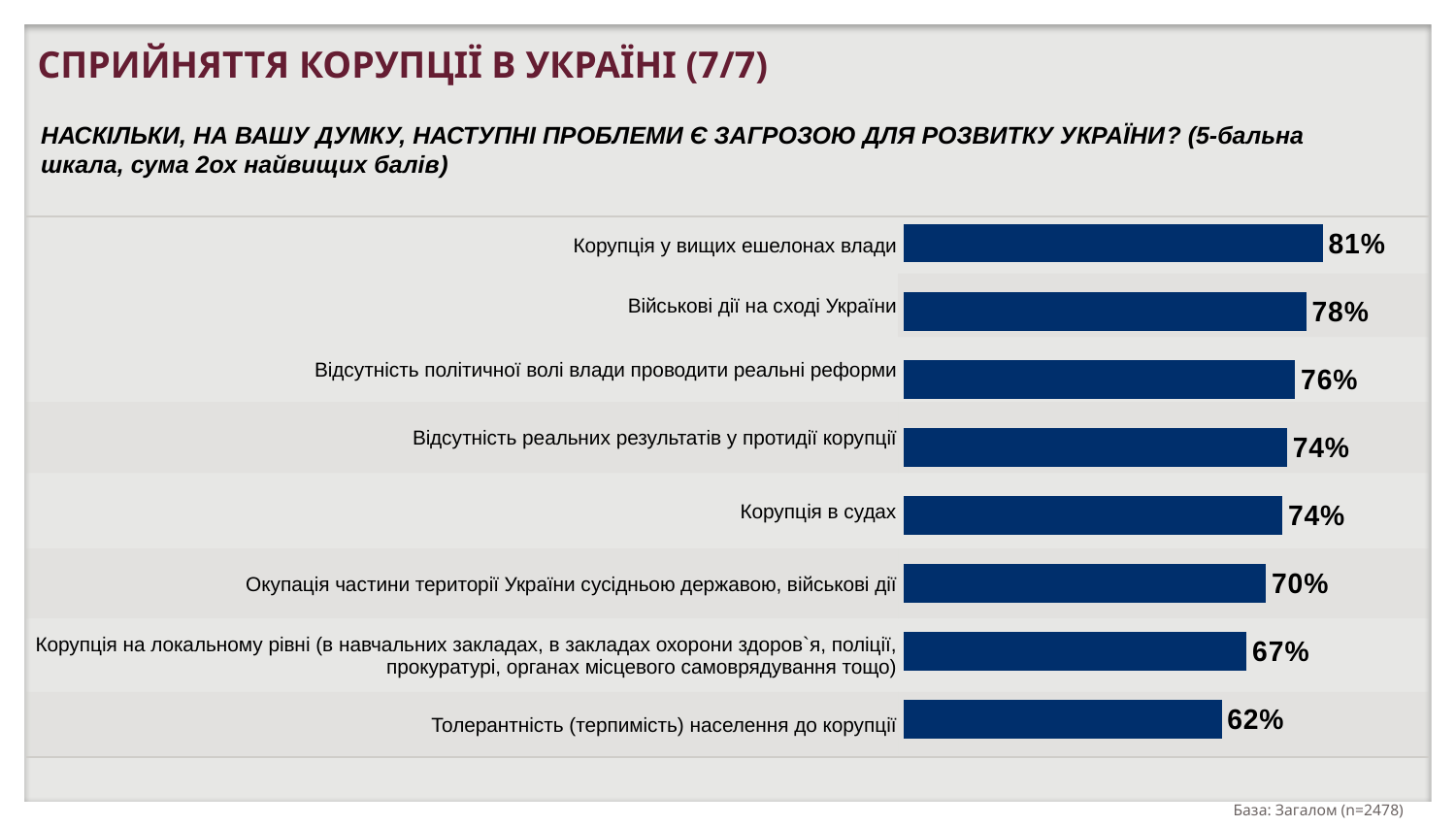
What value is shown for "Корупція у вищих ешелонах влади"? 81% Which category has the lowest value? Толерантність (терпимість) населення до корупції How many categories are shown in the chart? 8 What value is shown for "Окупація частини території України сусідньою державою, військові дії"? 70% Which category has the highest value? Корупція у вищих ешелонах влади Which is larger: the value for "Військові дії на сході України" or the value for "Корупція в судах"? Військові дії на сході України What is the sample size (base) stated at the bottom of the slide? n=2478 What value is shown for "Толерантність (терпимість) населення до корупції"? 62% What value is shown for "Військові дії на сході України"? 78% What kind of chart is shown on the slide? Bar chart What is the difference between the values for "Корупція у вищих ешелонах влади" and "Толерантність (терпимість) населення до корупції"? 19% What is the difference between the values for "Відсутність політичної волі влади проводити реальні реформи" and "Окупація частини території України сусідньою державою, військові дії"? 6%